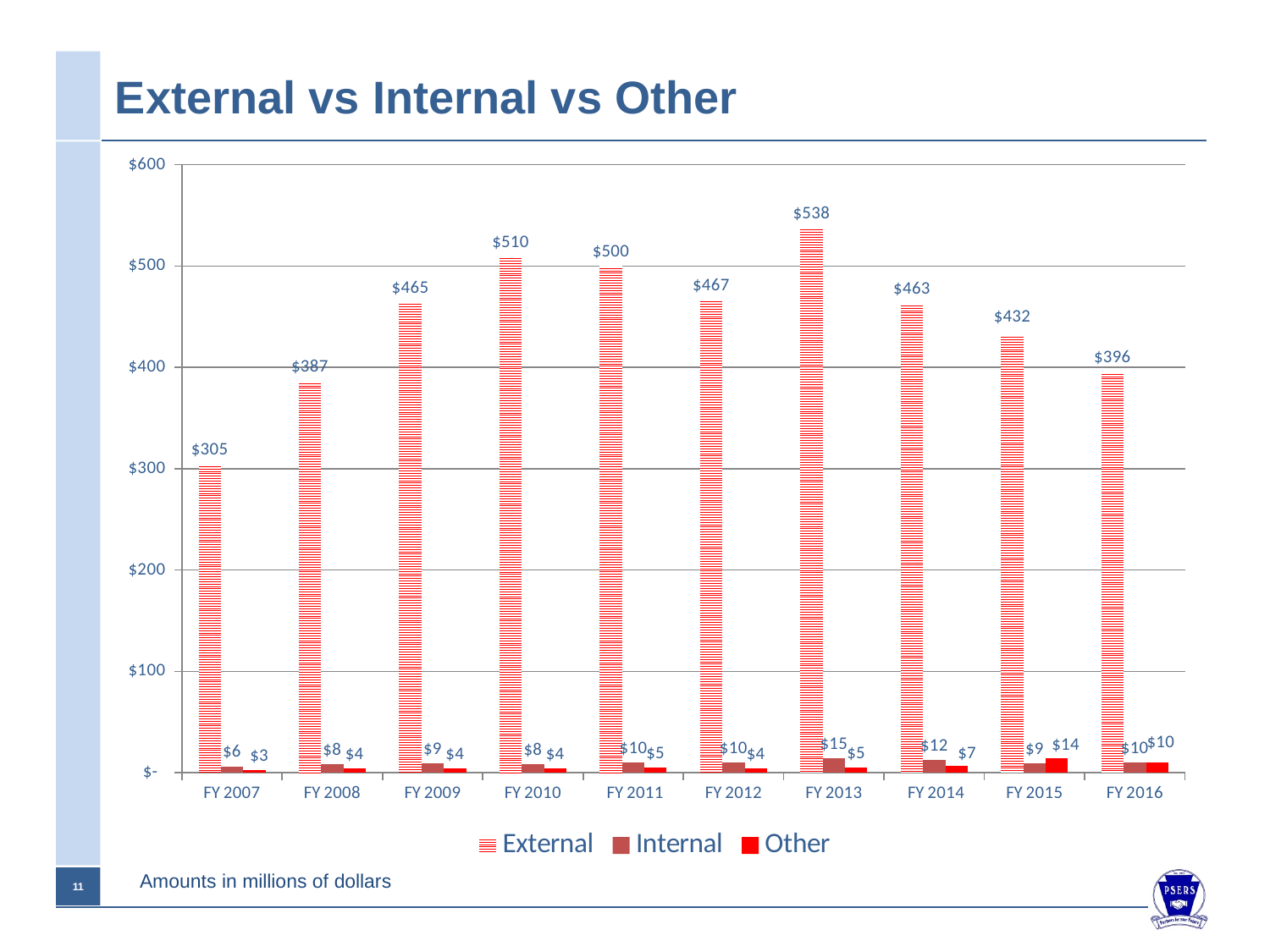
Which fiscal year has the highest External value? FY 2013 Which is larger, the External value for FY 2009 or for FY 2012? FY 2012 What is the Internal value for FY 2014? $12 What is the title of the chart? External vs Internal vs Other What is the External value for FY 2013? $538 Is the External value for FY 2008 greater or less than $400? less How many fiscal years are shown on the x axis? 10 What is the difference between the External values for FY 2010 and FY 2016? $114 How many series does the legend list? 3 What kind of chart is shown on the slide? bar chart What is the Other value for FY 2015? $14 Which fiscal year has the lowest External value? FY 2007